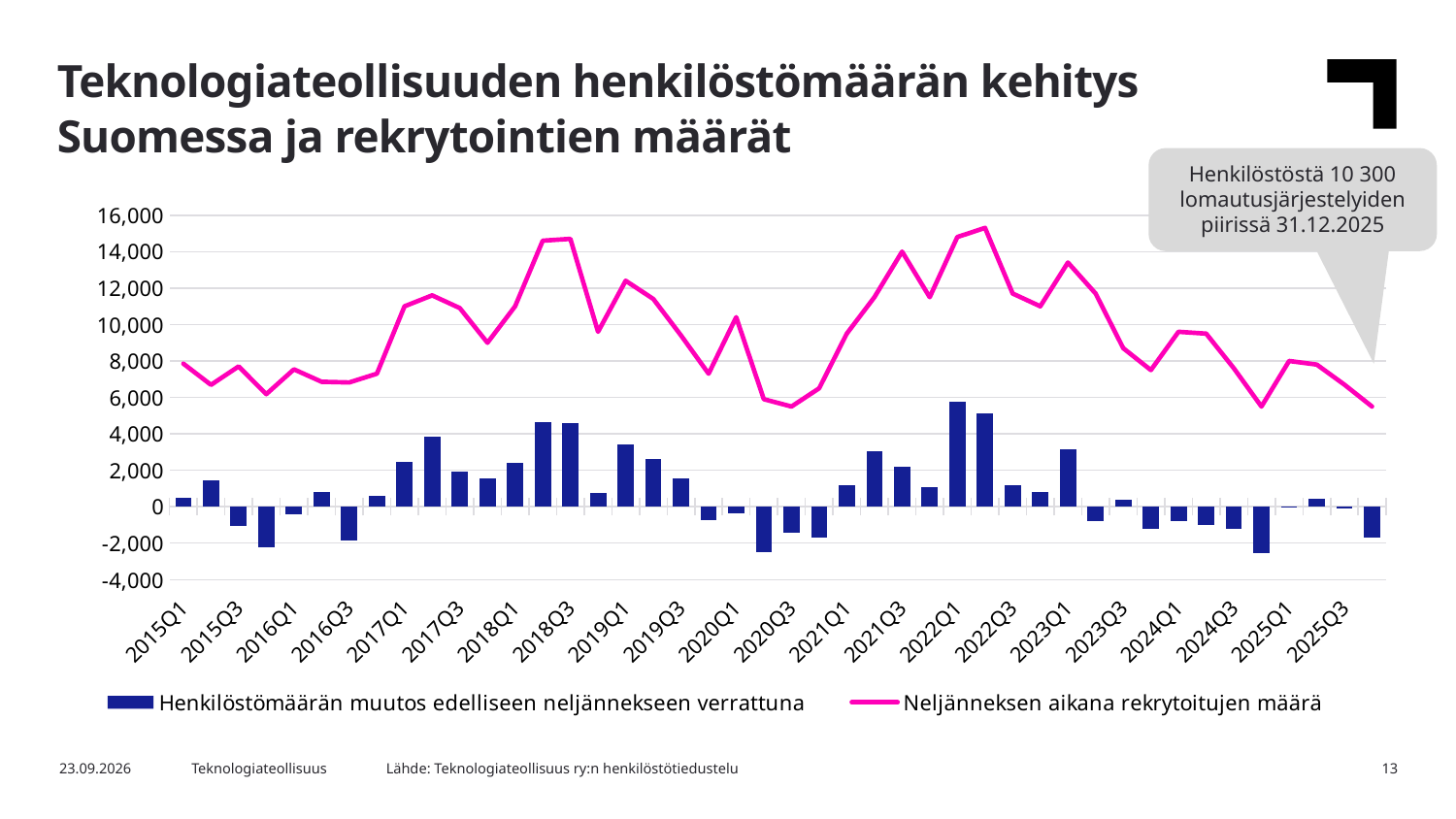
Which is larger, the recruited number (line) for 2017Q1 or for 2015Q1? 2017Q1 Which quarter has the highest bar for Henkilöstömäärän muutos edelliseen neljännekseen verrattuna? 2022Q1 Is the value of Neljänneksen aikana rekrytoitujen määrä for 2017Q1 greater or less than 10,000? greater Is the bar for Henkilöstömäärän muutos edelliseen neljännekseen verrattuna at 2020Q3 greater or less than -2,000? greater Does the line for Neljänneksen aikana rekrytoitujen määrä generally rise or fall from 2022Q3 to 2025Q3? fall How many series does the legend list? 2 According to the callout, how many employees were covered by lay-off arrangements on 31.12.2025? 10 300 Is the value of Neljänneksen aikana rekrytoitujen määrä for 2018Q3 greater or less than 14,000? greater What kind of chart is shown on the slide? Combined bar and line chart Which series is drawn as a line? Neljänneksen aikana rekrytoitujen määrä